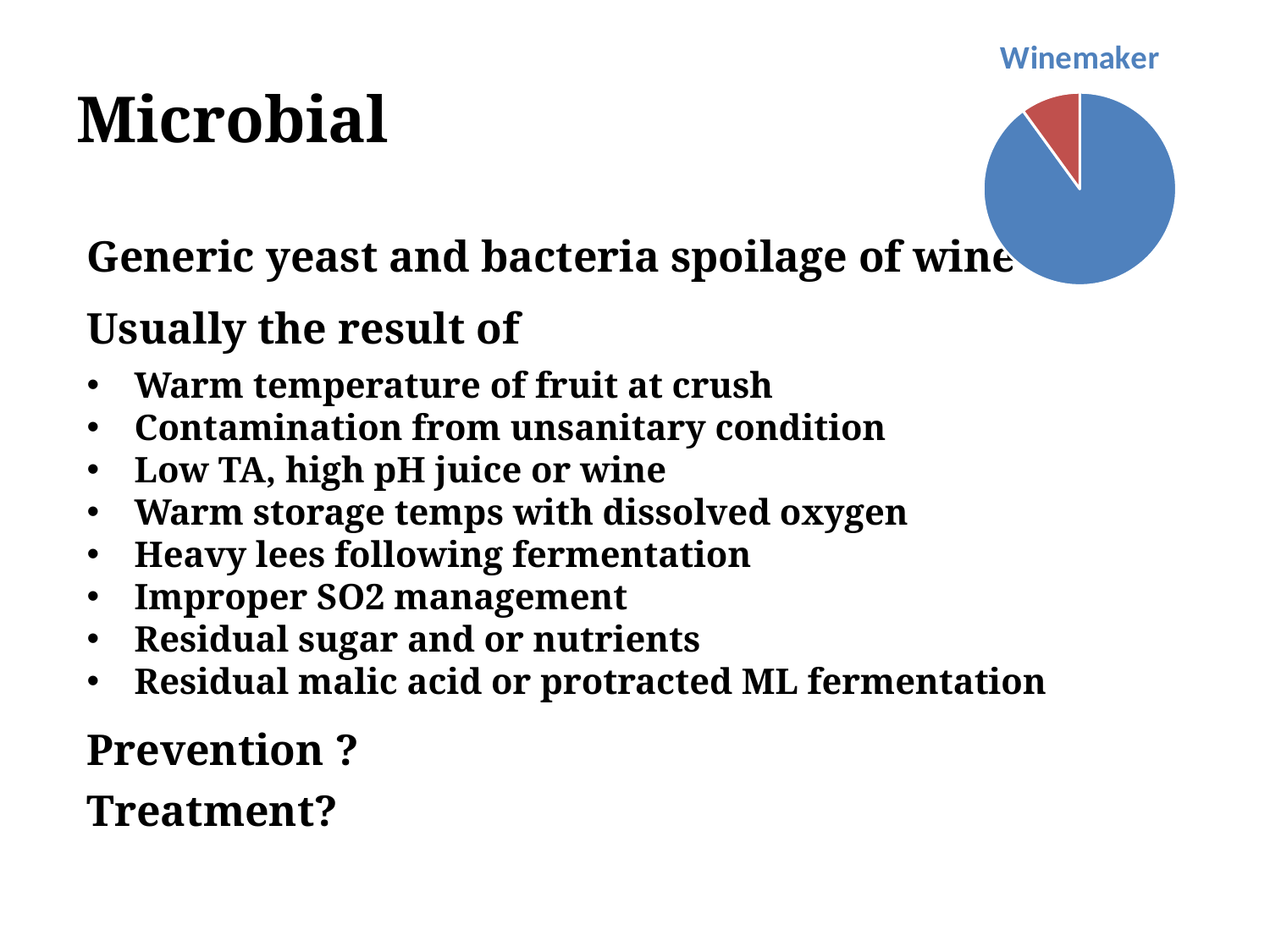
In the Winemaker pie chart, which slice is larger, the blue one or the red one? blue What is the title of the chart on the slide? Winemaker What kind of chart is shown on the slide? pie chart What colour is the largest slice of the Winemaker pie chart? blue How many slices does the Winemaker pie chart have? 2 In the Winemaker pie chart, which slice is the smallest? the red slice